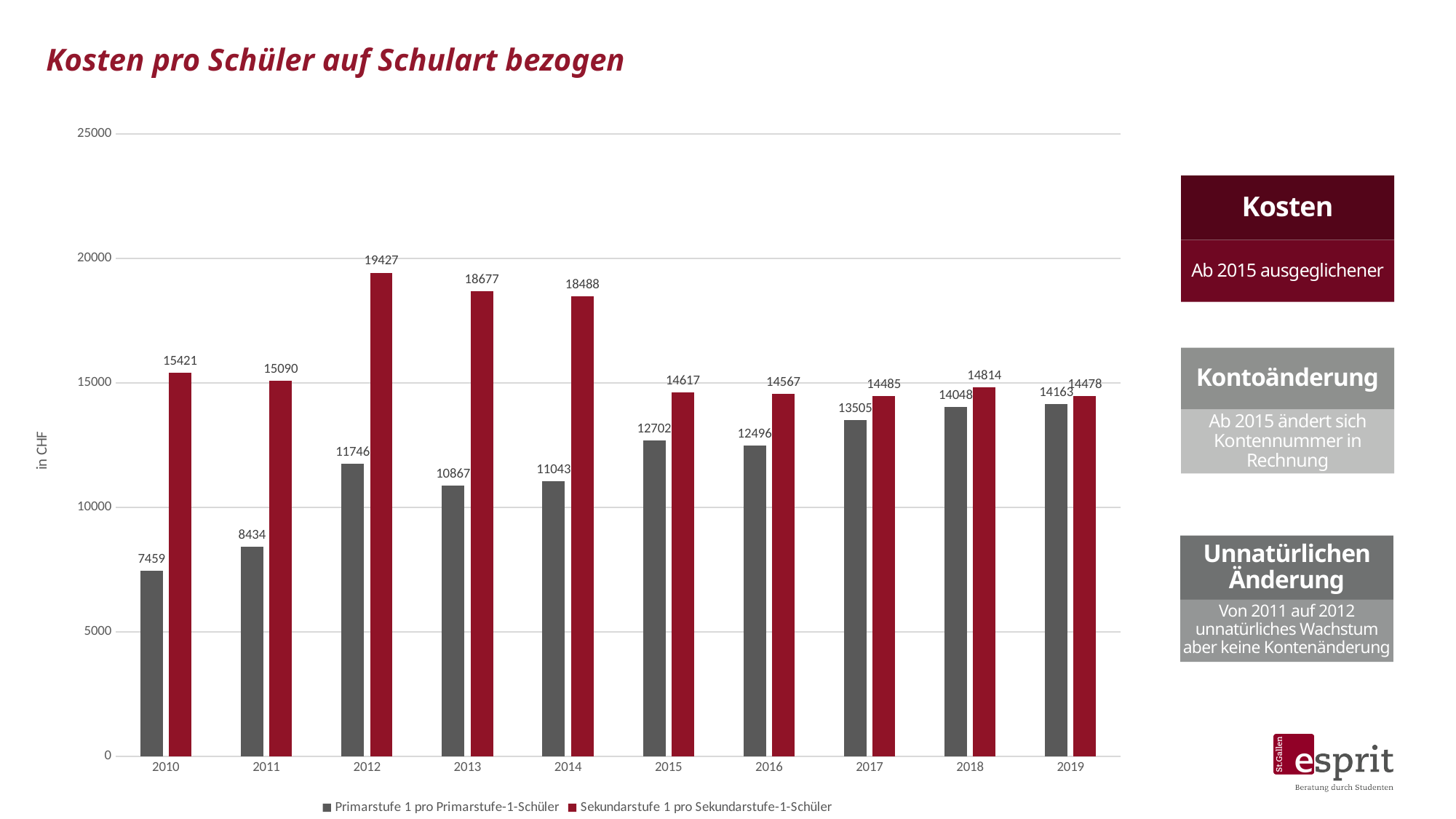
What is the title of the chart? Kosten pro Schüler auf Schulart bezogen In which year is the Primarstufe 1 pro Primarstufe-1-Schüler value lowest? 2010 How many years are shown on the x axis? 10 Which is larger in 2019: the Primarstufe 1 value or the Sekundarstufe 1 value? Sekundarstufe 1 pro Sekundarstufe-1-Schüler What is the value for Primarstufe 1 pro Primarstufe-1-Schüler in 2010? 7459 What is the value for Primarstufe 1 pro Primarstufe-1-Schüler in 2017? 13505 In which year is the Sekundarstufe 1 pro Sekundarstufe-1-Schüler value highest? 2012 What is the difference between the Sekundarstufe 1 and Primarstufe 1 values in 2013? 7810 What is the value for Sekundarstufe 1 pro Sekundarstufe-1-Schüler in 2012? 19427 What kind of chart is shown on the slide? bar chart Is the value for Primarstufe 1 pro Primarstufe-1-Schüler in 2011 greater or less than 10000? less How many series does the legend list? 2